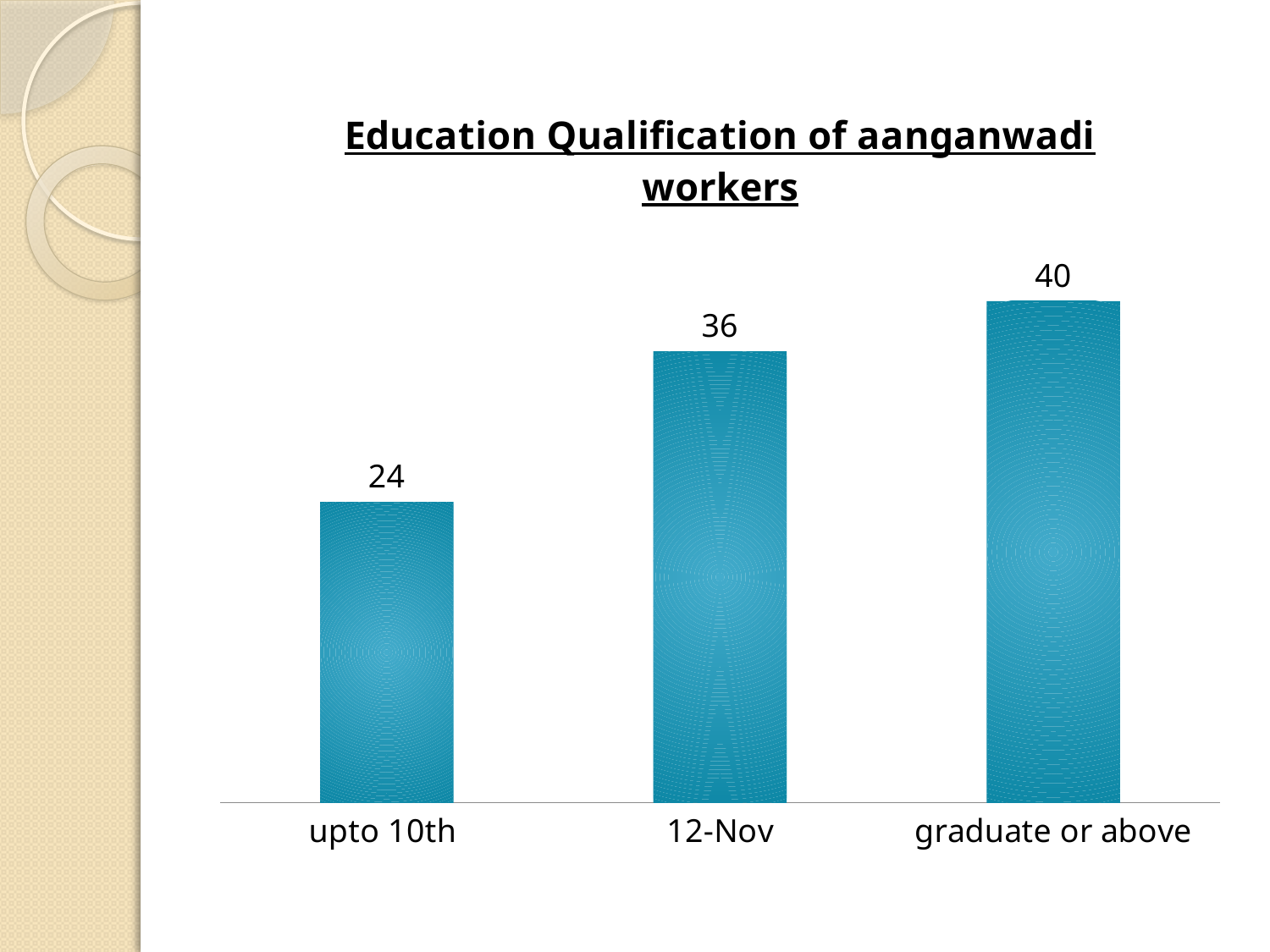
What is the value for "upto 10th"? 24 Which is larger, the value for "12-Nov" or the value for "graduate or above"? graduate or above Which category has the lowest value? upto 10th What is the value for "graduate or above"? 40 What is the value for "12-Nov"? 36 What is the difference between the values for "graduate or above" and "upto 10th"? 16 Which category has the highest value? graduate or above Do the values rise or fall from left to right along the x axis? rise What is the title of the chart? Education Qualification of aanganwadi workers What kind of chart is shown on the slide? bar chart What is the difference between the values for "12-Nov" and "upto 10th"? 12 How many categories are shown in the chart? 3